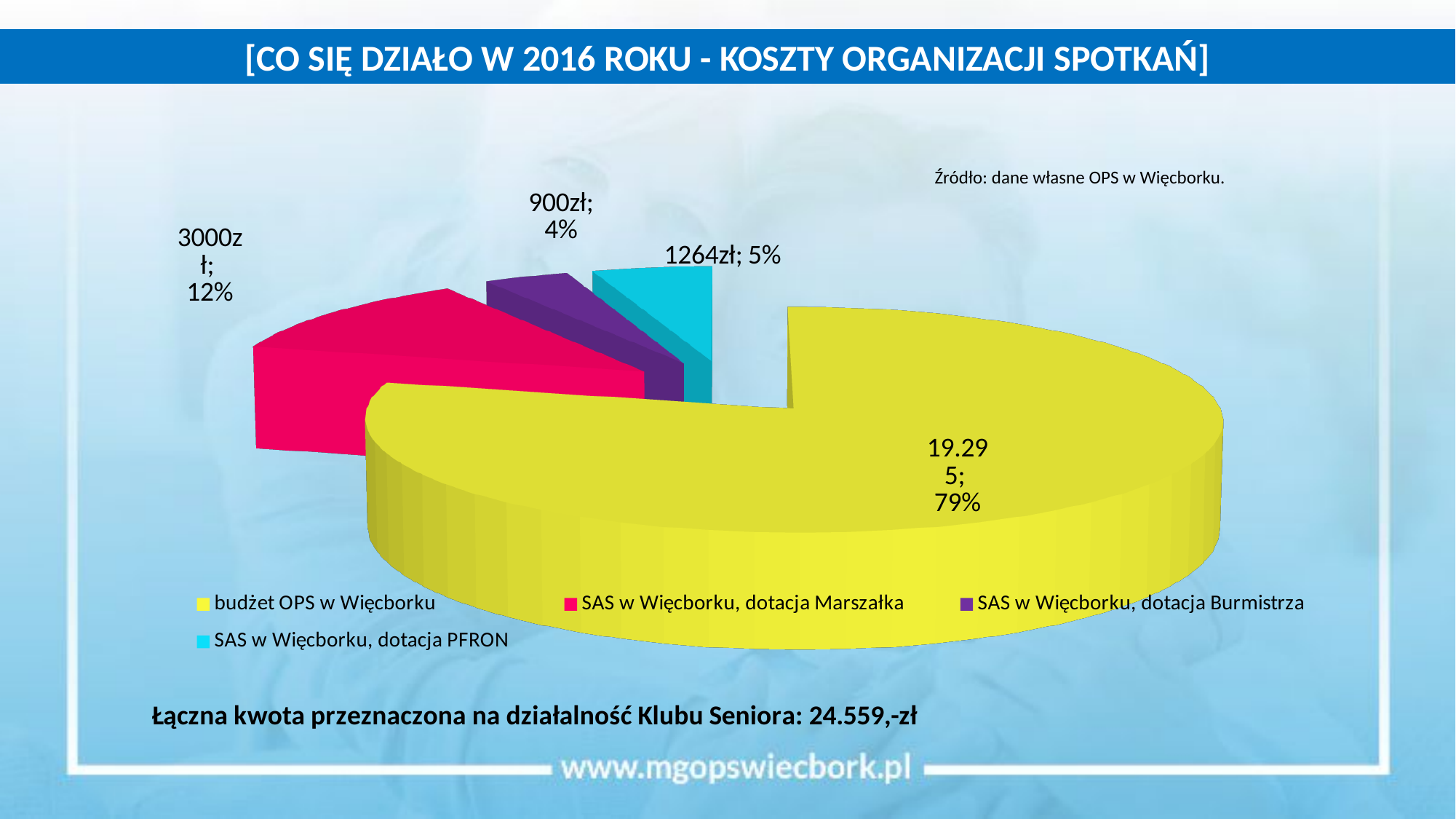
Which category has the largest slice of the pie? budżet OPS w Więcborku What value is labelled for 'SAS w Więcborku, dotacja PFRON'? 1264zł What share of the pie does 'SAS w Więcborku, dotacja Burmistrza' represent? 4% How many slices does the pie chart have? 4 What share of the pie does 'budżet OPS w Więcborku' represent? 79% What share of the pie does 'SAS w Więcborku, dotacja Marszałka' represent? 12% What kind of chart is shown on the slide? pie chart Which category has the smallest slice of the pie? SAS w Więcborku, dotacja Burmistrza How many entries does the legend list? 4 Which is larger: the slice for 'SAS w Więcborku, dotacja PFRON' or the slice for 'SAS w Więcborku, dotacja Burmistrza'? SAS w Więcborku, dotacja PFRON What value is labelled for 'SAS w Więcborku, dotacja Marszałka'? 3000zł